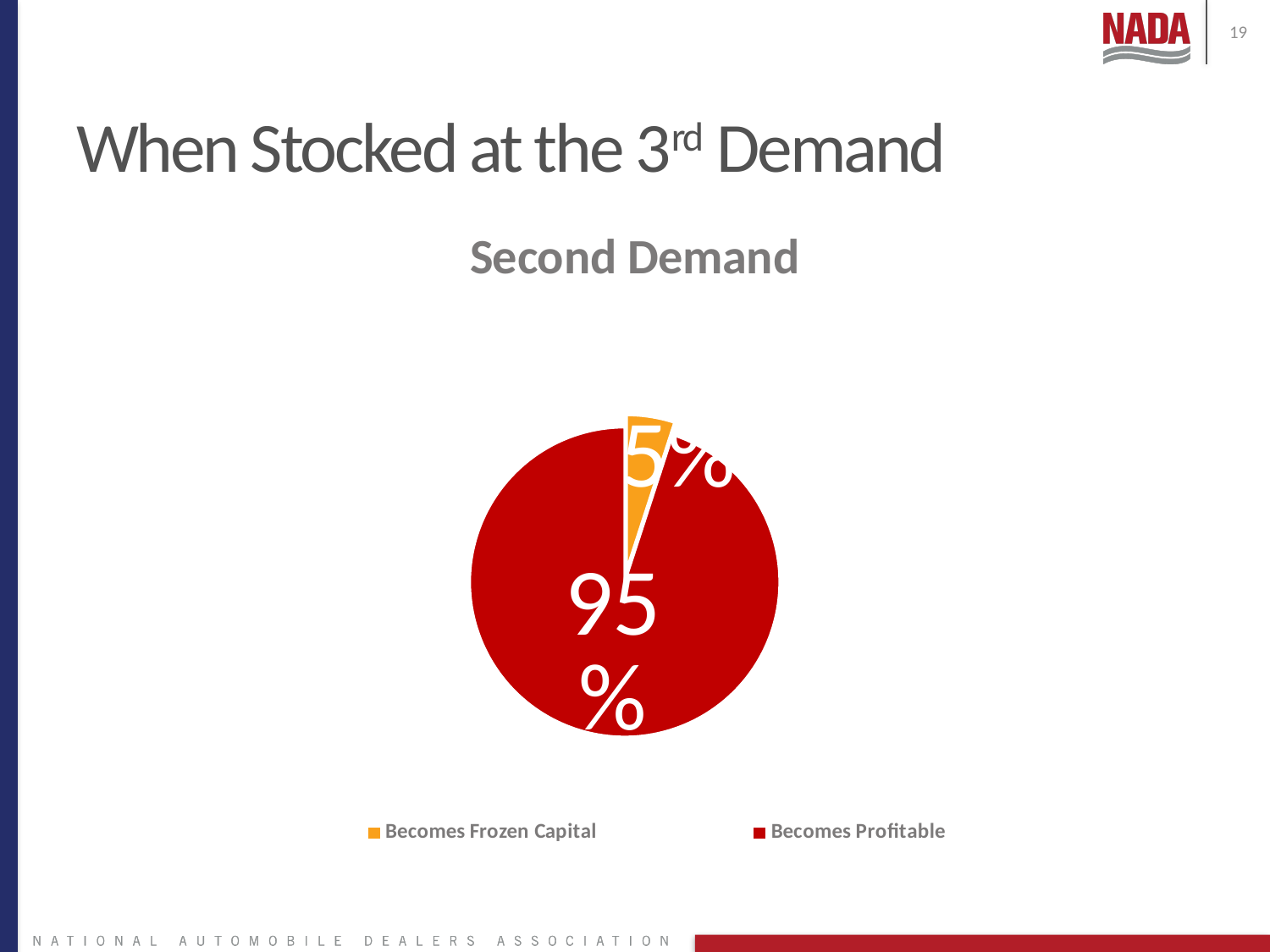
What is the chart's title? Second Demand What share of the pie does Becomes Frozen Capital take? 5% What colour is the Becomes Frozen Capital slice? orange How many entries does the legend list? 2 What kind of chart is shown on the slide? pie chart Which slice is the smallest? Becomes Frozen Capital Which is larger, Becomes Frozen Capital or Becomes Profitable? Becomes Profitable What is the difference between the Becomes Profitable share and the Becomes Frozen Capital share? 90% What share of the pie does Becomes Profitable take? 95% Which slice is the largest? Becomes Profitable How many slices does the pie chart have? 2